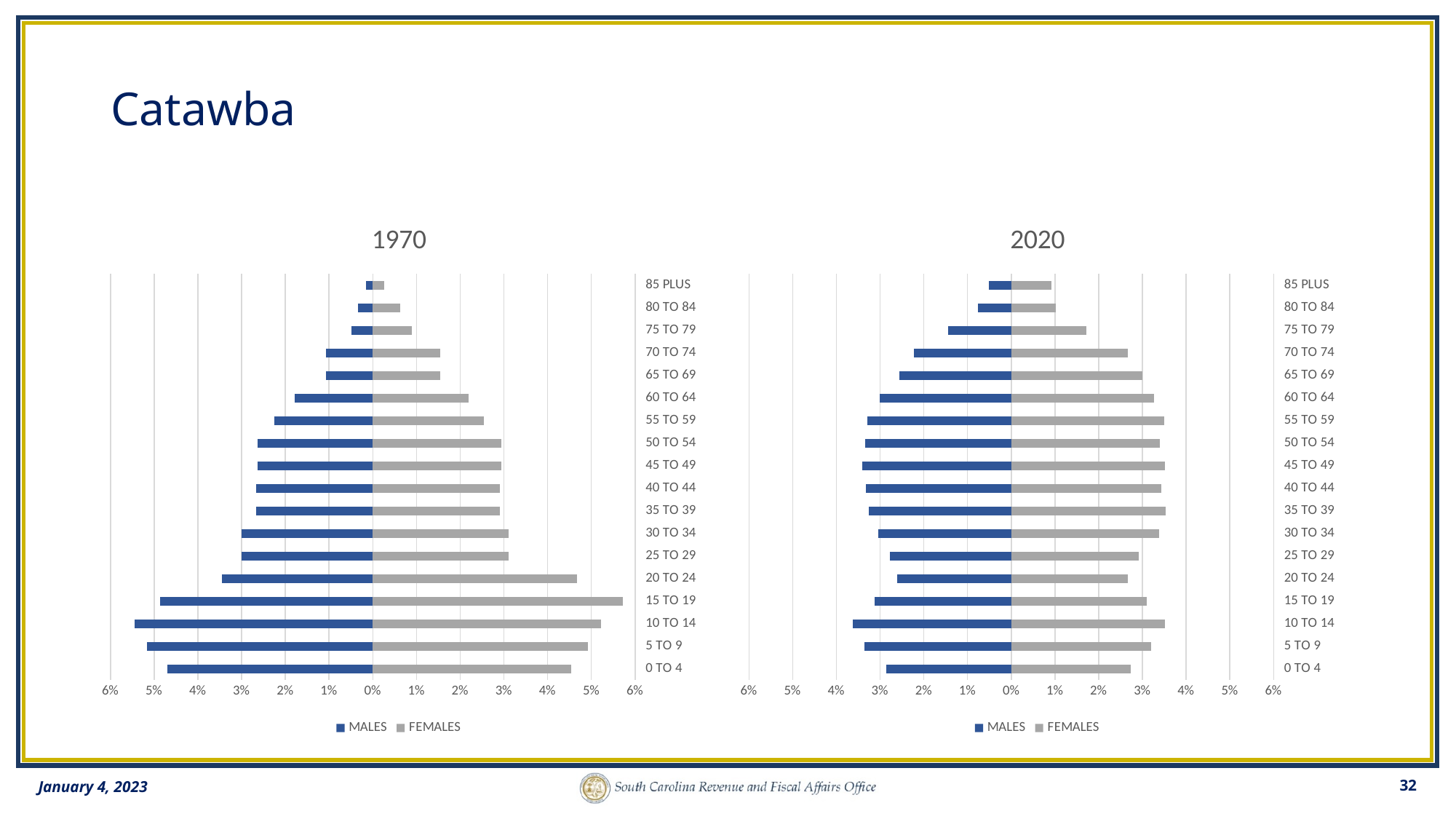
In the 1970 chart, which age group has the smallest MALES bar? 85 PLUS In the 2020 chart, is the FEMALES value for 75 TO 79 greater or less than 1%? greater What colour are the MALES bars in the 2020 chart? blue How many series does the legend of the 2020 chart list? 2 In the 1970 chart, which is larger for the 20 TO 24 age group, MALES or FEMALES? FEMALES What kind of chart is the 1970 chart? bar chart In the 1970 chart, is the MALES value for 15 TO 19 greater or less than 4%? greater In the 1970 chart, as age increases from 0 TO 4 toward 85 PLUS, do the MALES bars generally get longer or shorter? shorter In the 1970 chart, which age group has the largest FEMALES bar? 15 TO 19 In the 2020 chart, which age group has the smallest FEMALES bar? 85 PLUS In the 2020 chart, is the MALES value for 85 PLUS greater or less than 1%? less How many age-group categories are shown on the 1970 chart? 18